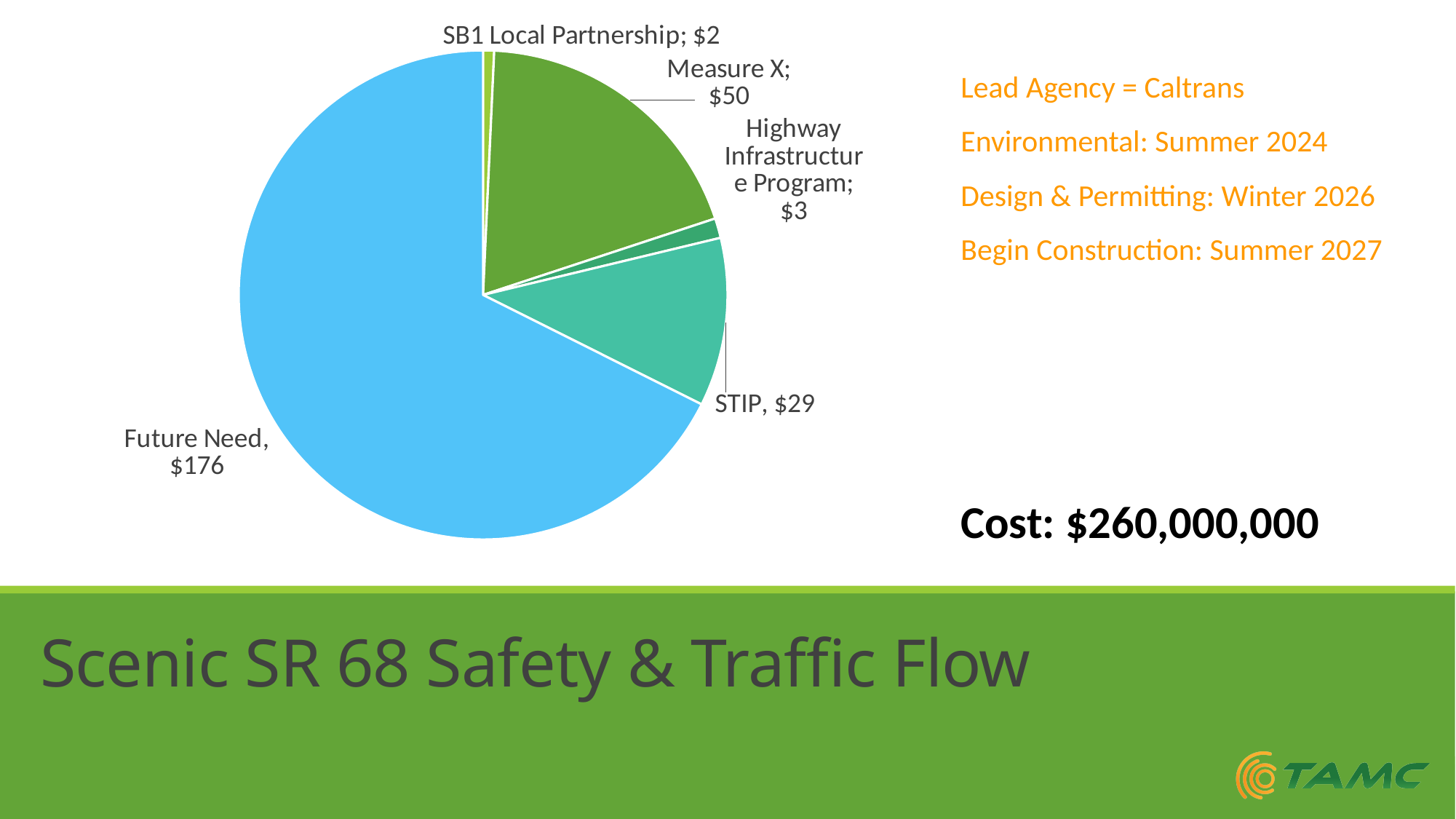
What is the difference between the Future Need and Measure X values? $126 Which slice of the pie chart is the smallest? SB1 Local Partnership What is the value of the STIP slice? $29 How many slices does the pie chart have? 5 What is the value of the Future Need slice? $176 What is the value of the Measure X slice? $50 What is the value of the SB1 Local Partnership slice? $2 What kind of chart is shown on the slide? Pie chart What is the total of all the slices in the pie chart? $260 Which is larger, the STIP slice or the Measure X slice? Measure X Which slice of the pie chart is the largest? Future Need What is the value of the Highway Infrastructure Program slice? $3